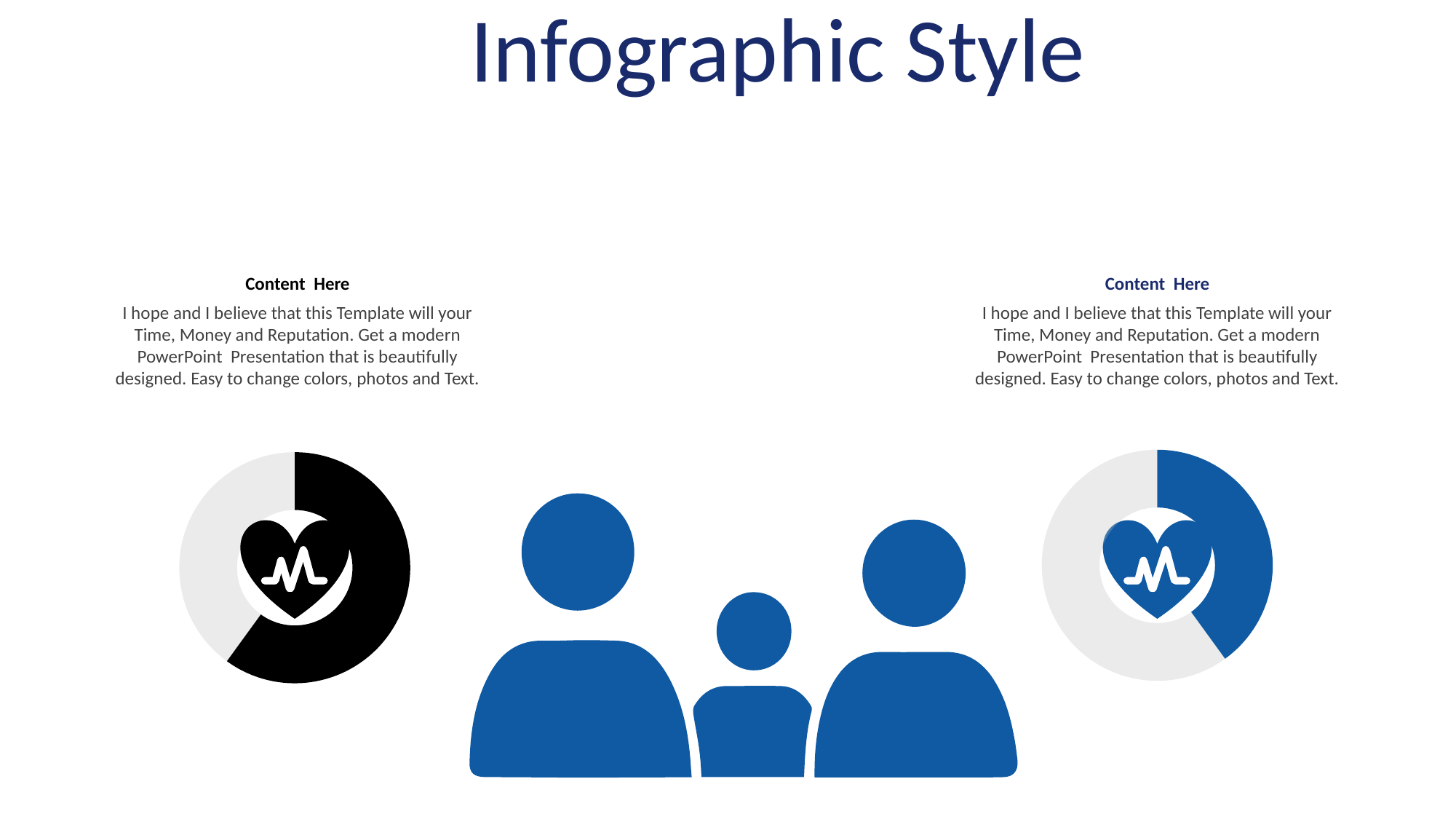
What colour is the filled portion of the left donut chart? Black Is the filled portion of the right donut chart greater or less than half of the ring? less Do the donut charts on the slide display any data labels or percentage values? No What colour is the filled portion of the right donut chart? Blue Which donut chart has the larger filled portion, the left one or the right one? The left one What kind of chart is shown on the right side of the slide, around the heart icon? Donut chart How many donut charts are on the slide? 2 What kind of chart is shown on the left side of the slide, around the heart icon? Donut chart Is the filled portion of the left donut chart greater or less than half of the ring? greater